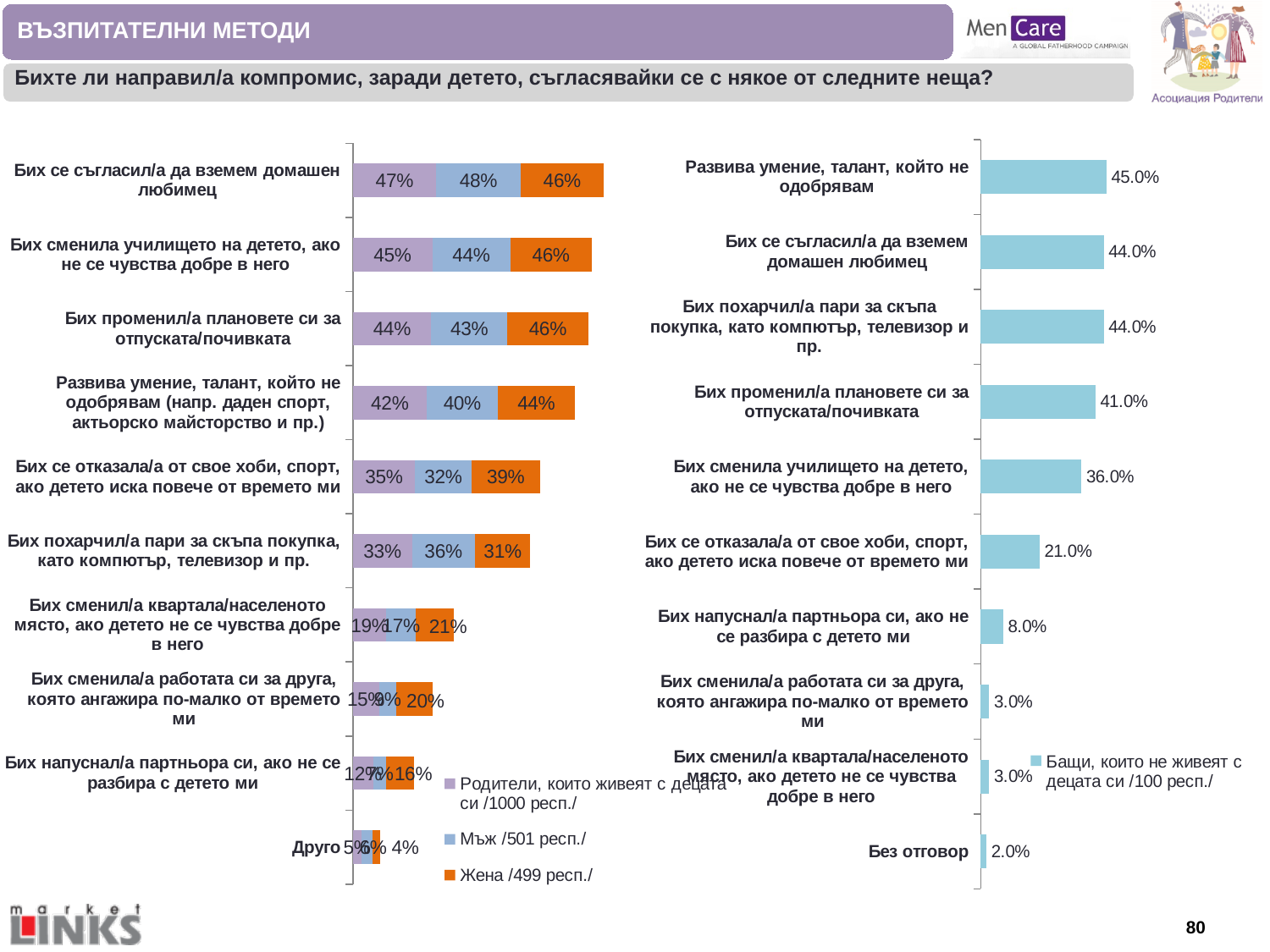
In the right chart, which category has the highest value? Развива умение, талант, който не одобрявам In the left chart, what is the value for 'Жена /499 респ./' for 'Бих се отказала/а от свое хоби, спорт, ако детето иска повече от времето ми'? 39% In the right chart, what is the value for 'Бих сменила училището на детето, ако не се чувства добре в него'? 36.0% In the left chart, what is the value for 'Мъж /501 респ./' for 'Бих похарчил/а пари за скъпа покупка, като компютър, телевизор и пр.'? 36% In the left chart, what is the difference between the 'Жена /499 респ./' and 'Мъж /501 респ./' values for 'Развива умение, талант, който не одобрявам (напр. даден спорт, актьорско майсторство и пр.)'? 4% In the left chart, for 'Бих се отказала/а от свое хоби, спорт, ако детето иска повече от времето ми', which is larger: the value for 'Мъж /501 респ./' or for 'Жена /499 респ./'? Жена /499 респ./ In the right chart, which category has the lowest value? Без отговор What type of chart is the right chart? Bar chart In the left chart, what is the value for 'Родители, които живеят с децата си /1000 респ./' for 'Бих се съгласил/а да вземем домашен любимец'? 47% How many series does the legend of the left chart list? 3 In the right chart, what is the difference between the values for 'Бих се отказала/а от свое хоби, спорт, ако детето иска повече от времето ми' and 'Бих напуснал/а партньора си, ако не се разбира с детето ми'? 13.0% How many categories are shown in the right chart? 10